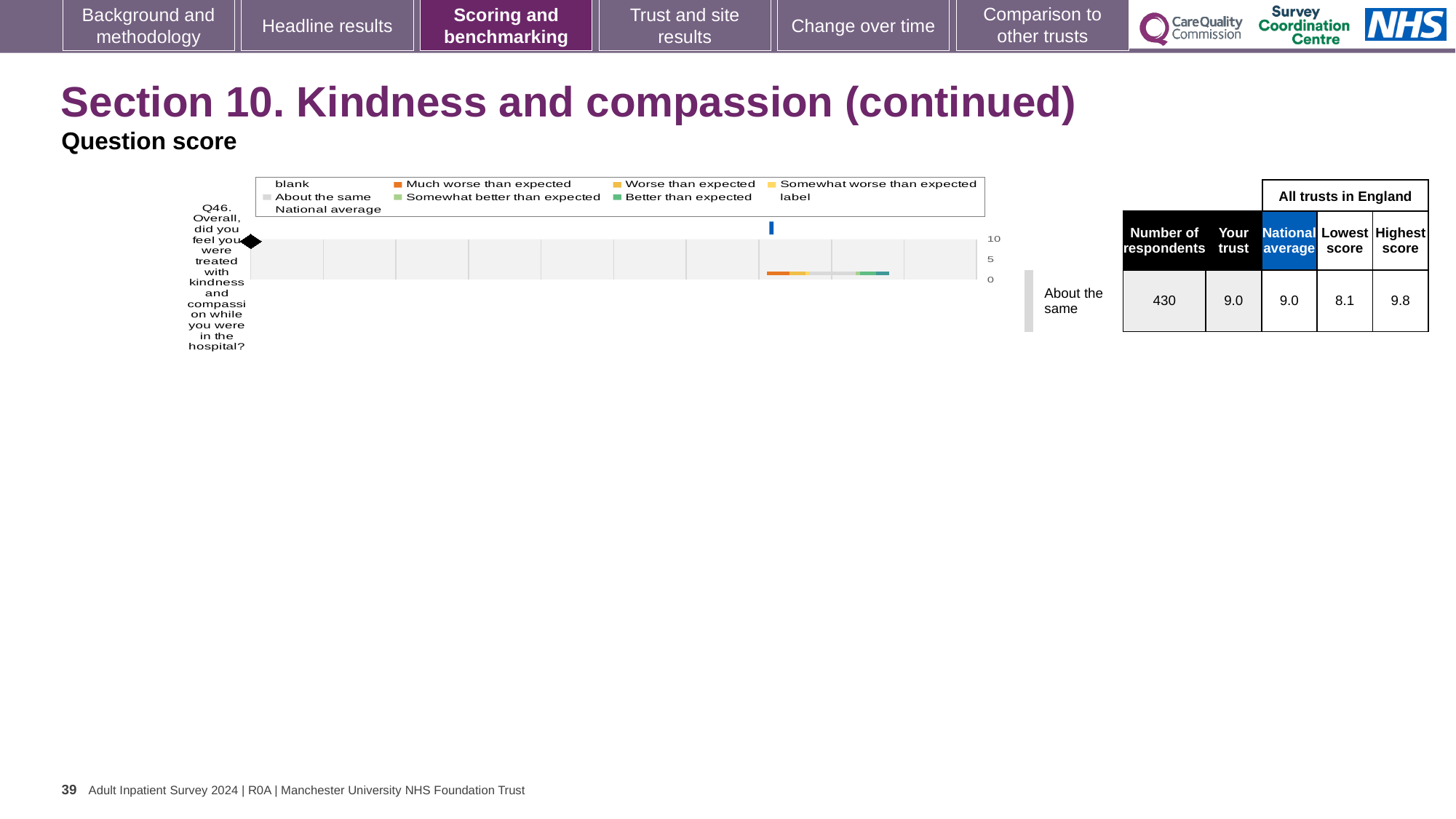
Which benchmark category is the trust's Q46 score assigned to? About the same What is the lowest score among all trusts in England for Q46? 8.1 What kind of chart is shown on the slide? bar chart What is the highest score among all trusts in England for Q46? 9.8 What is the national average score for Q46 shown next to the chart? 9.0 How many questions (categories) are plotted on the chart? 1 What is the highest value shown on the chart's axis? 10 What is the 'Your trust' score for Q46 shown next to the chart? 9.0 Which question number is plotted on the chart? Q46 Is the national average marker for Q46 greater or less than 5 on the axis? greater What is the difference between the highest score and the lowest score for Q46? 1.7 How many respondents are shown for Q46? 430